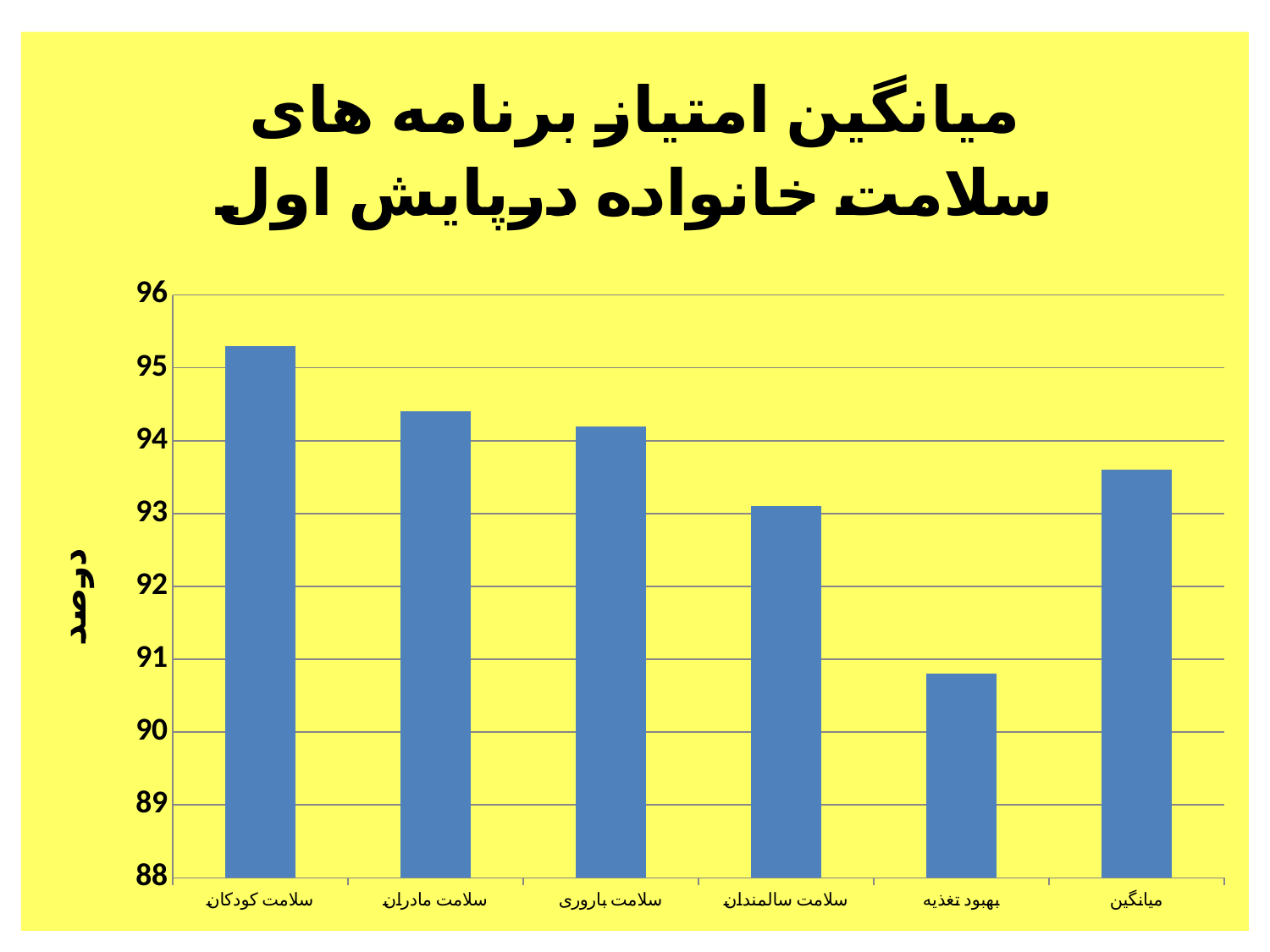
Which is larger, the value for سلامت مادران or the value for سلامت سالمندان? سلامت مادران Which category has the lowest bar in the chart? بهبود تغذیه Is the value for میانگین greater or less than 94? less Which is larger, the value for سلامت کودکان or the value for بهبود تغذیه? سلامت کودکان Is the value for سلامت کودکان greater or less than 95? greater Which category has the highest bar in the chart? سلامت کودکان What kind of chart is shown on the slide? bar chart How many categories are shown on the x axis of the chart? 6 Is the value for بهبود تغذیه greater or less than 91? less What is the label on the vertical axis of the chart? درصد What is the lowest value shown on the vertical axis of the chart? 88